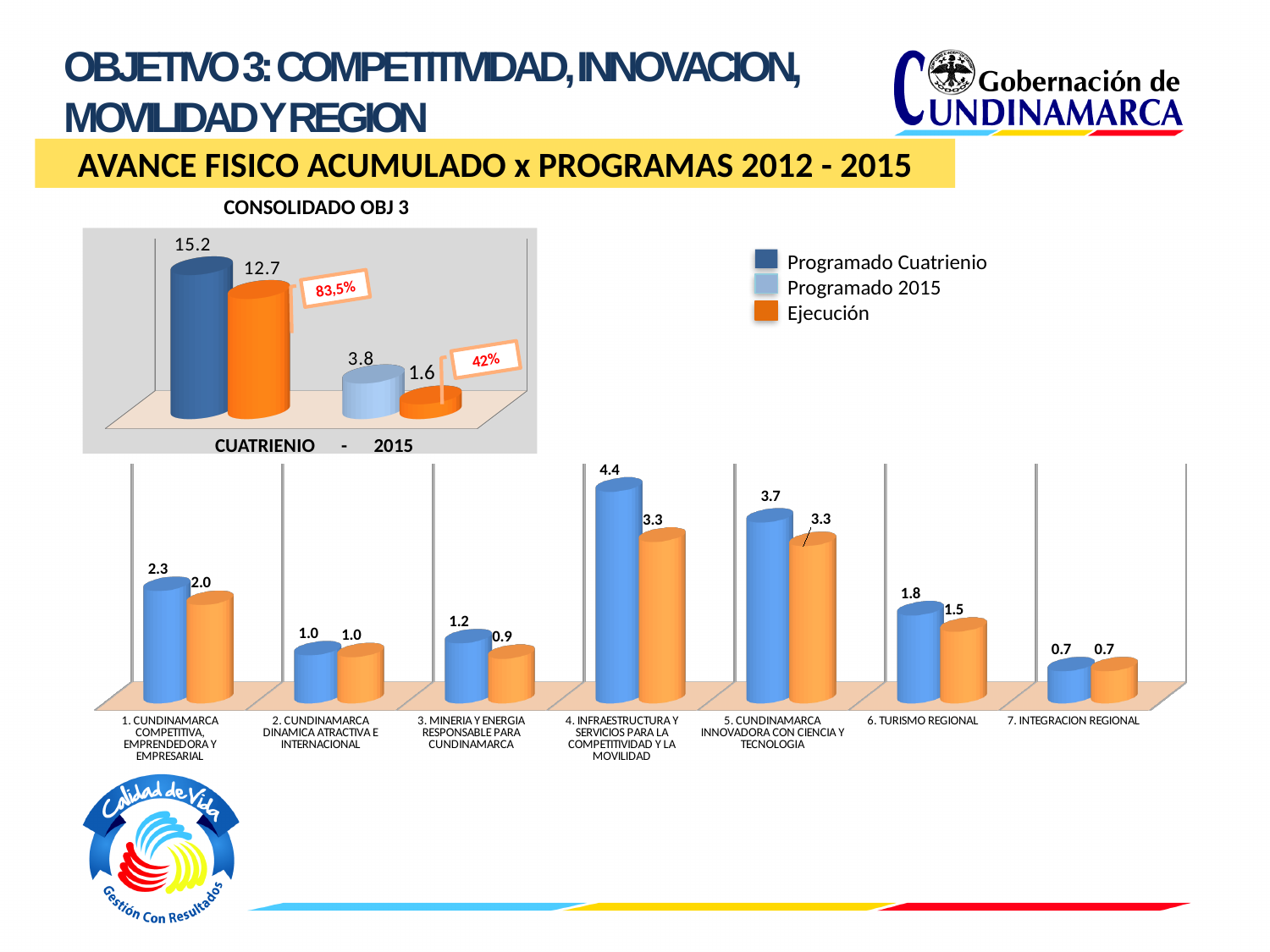
In the CONSOLIDADO OBJ 3 chart, what is the Programado Cuatrienio value for CUATRIENIO? 15.2 How many programs are shown in the lower chart? 7 In the lower chart by programs, what is the value of the blue bar for 4. INFRAESTRUCTURA Y SERVICIOS PARA LA COMPETITIVIDAD Y LA MOVILIDAD? 4.4 In the lower chart by programs, which program has the highest blue bar? 4. INFRAESTRUCTURA Y SERVICIOS PARA LA COMPETITIVIDAD Y LA MOVILIDAD In the CONSOLIDADO OBJ 3 chart, what percentage label is shown next to the CUATRIENIO bars? 83,5% What kind of chart is the lower chart by programs? Bar chart In the lower chart by programs, what is the value of the orange bar for 6. TURISMO REGIONAL? 1.5 In the lower chart by programs, which program has the lowest orange bar? 7. INTEGRACION REGIONAL How many series does the legend on the slide list? 3 In the lower chart by programs, what is the difference between the blue bar (4.4) and the orange bar (3.3) for 4. INFRAESTRUCTURA Y SERVICIOS PARA LA COMPETITIVIDAD Y LA MOVILIDAD? 1.1 In the CONSOLIDADO OBJ 3 chart, what is the Ejecución value for 2015? 1.6 In the CONSOLIDADO OBJ 3 chart, what is the difference between the Programado Cuatrienio value (15.2) and the Ejecución value (12.7) for CUATRIENIO? 2.5